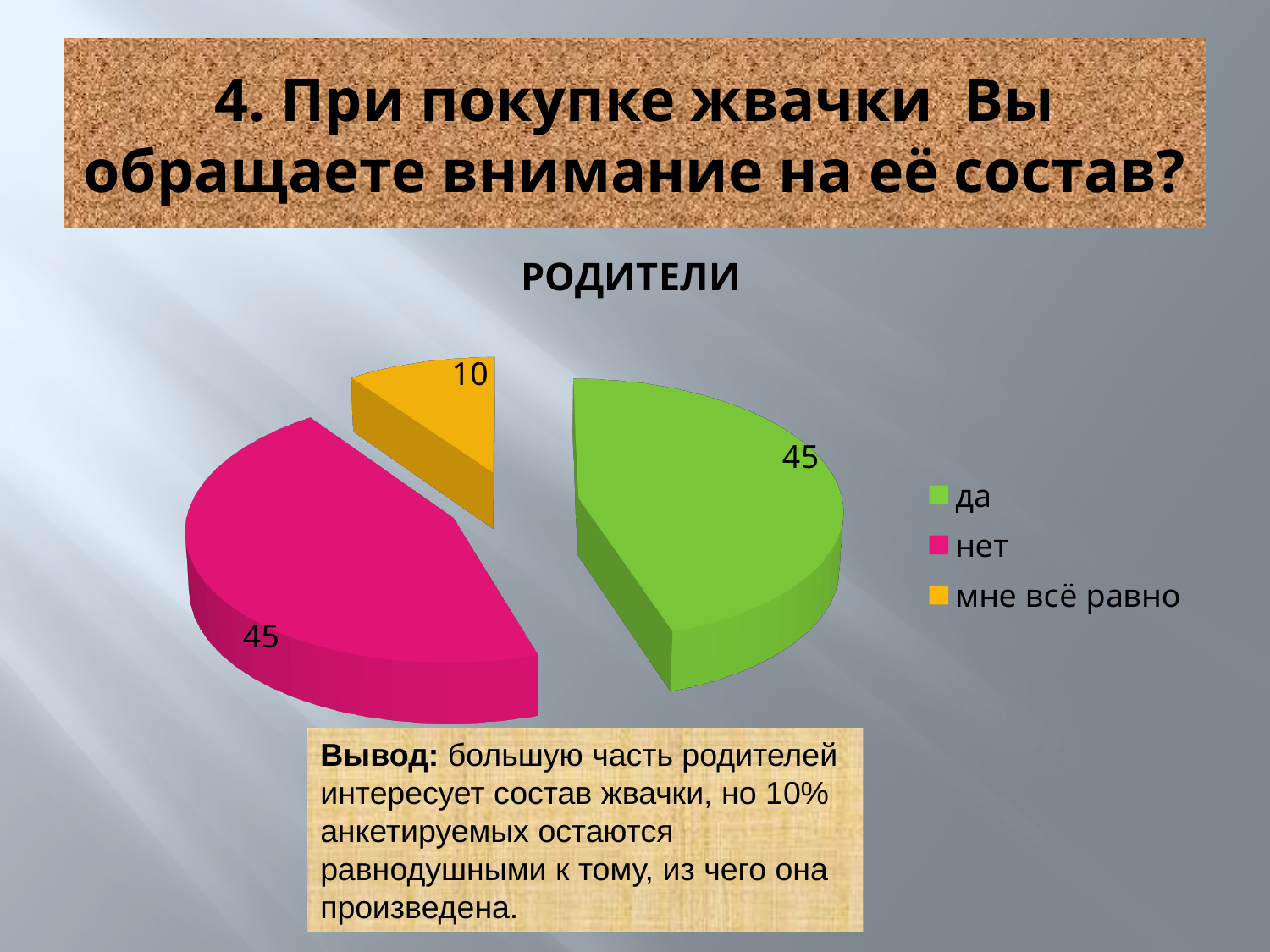
What value is shown for the "мне всё равно" slice of the pie chart? 10 What value is shown for the "да" slice of the pie chart? 45 How many entries does the legend of the pie chart list? 3 What kind of chart is shown on the slide? pie chart What is the title of the pie chart? РОДИТЕЛИ What is the difference between the values for "да" and "мне всё равно"? 35 What is the total of all the values shown in the pie chart? 100 What value is shown for the "нет" slice of the pie chart? 45 Which is larger, the value for "нет" or the value for "мне всё равно"? нет How many slices does the pie chart have? 3 Which category has the smallest slice in the pie chart? мне всё равно What share of the pie does the "мне всё равно" slice represent? 10%